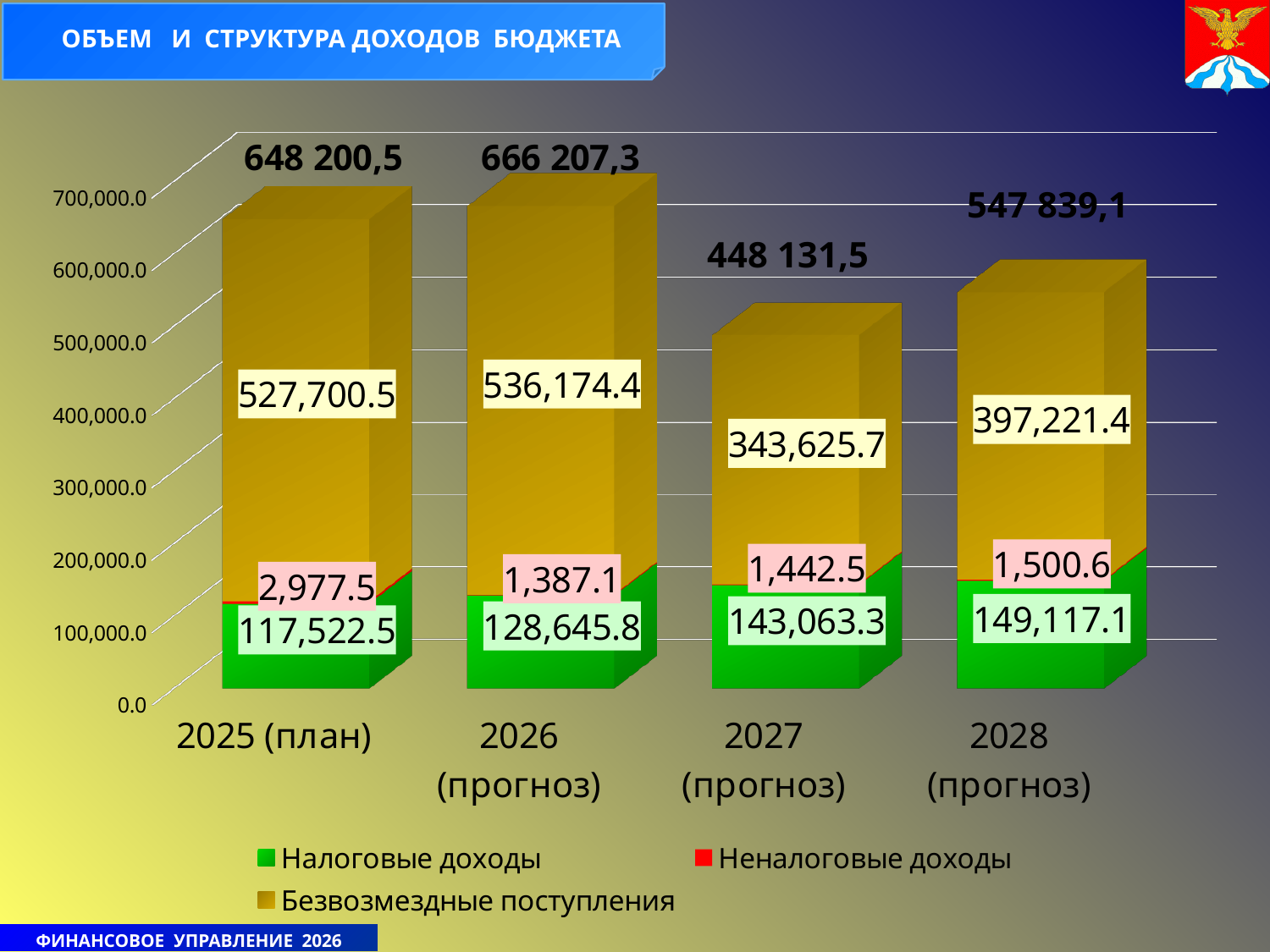
How many series does the legend list? 3 What is the value of Налоговые доходы for 2025 (план)? 117,522.5 What is the value of Неналоговые доходы for 2028 (прогноз)? 1,500.6 What kind of chart is shown on the slide? Stacked bar chart What is the total of the stacked bar for 2025 (план)? 648 200,5 Do the values of Налоговые доходы rise or fall from 2025 to 2028? Rise How many years (categories) are shown on the x axis? 4 What is the difference between Налоговые доходы in 2028 (прогноз) and in 2025 (план)? 31,594.6 In which year is the value of Неналоговые доходы the lowest? 2026 (прогноз) What is the value of Безвозмездные поступления for 2027 (прогноз)? 343,625.7 In which year is the value of Безвозмездные поступления the highest? 2026 (прогноз) Which is larger: Безвозмездные поступления in 2027 (прогноз) or in 2028 (прогноз)? 2028 (прогноз)